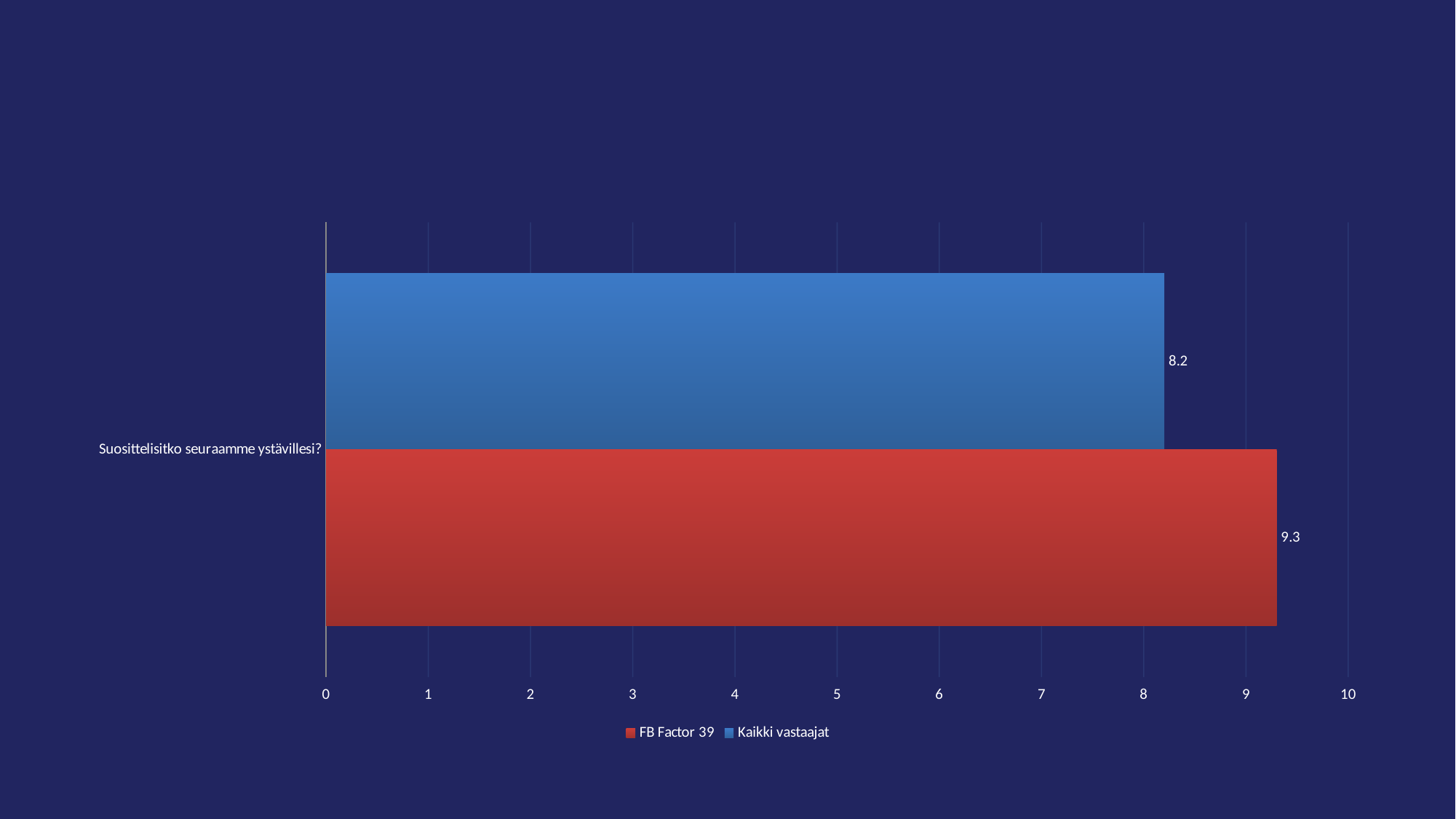
What kind of chart is shown on the slide? Bar chart Is the value for FB Factor 39 greater or less than 9? greater How many categories are shown on the chart? 1 What is the maximum value shown on the x axis? 10 Which series has the lowest value? Kaikki vastaajat What is the difference between the FB Factor 39 value and the Kaikki vastaajat value? 1.1 How many series does the legend list? 2 What is the value for FB Factor 39 for "Suosittelisitko seuraamme ystävillesi?"? 9.3 Which series has the higher value: FB Factor 39 or Kaikki vastaajat? FB Factor 39 Which series is shown in red? FB Factor 39 What is the value for Kaikki vastaajat for "Suosittelisitko seuraamme ystävillesi?"? 8.2 Is the value for Kaikki vastaajat greater or less than 9? less